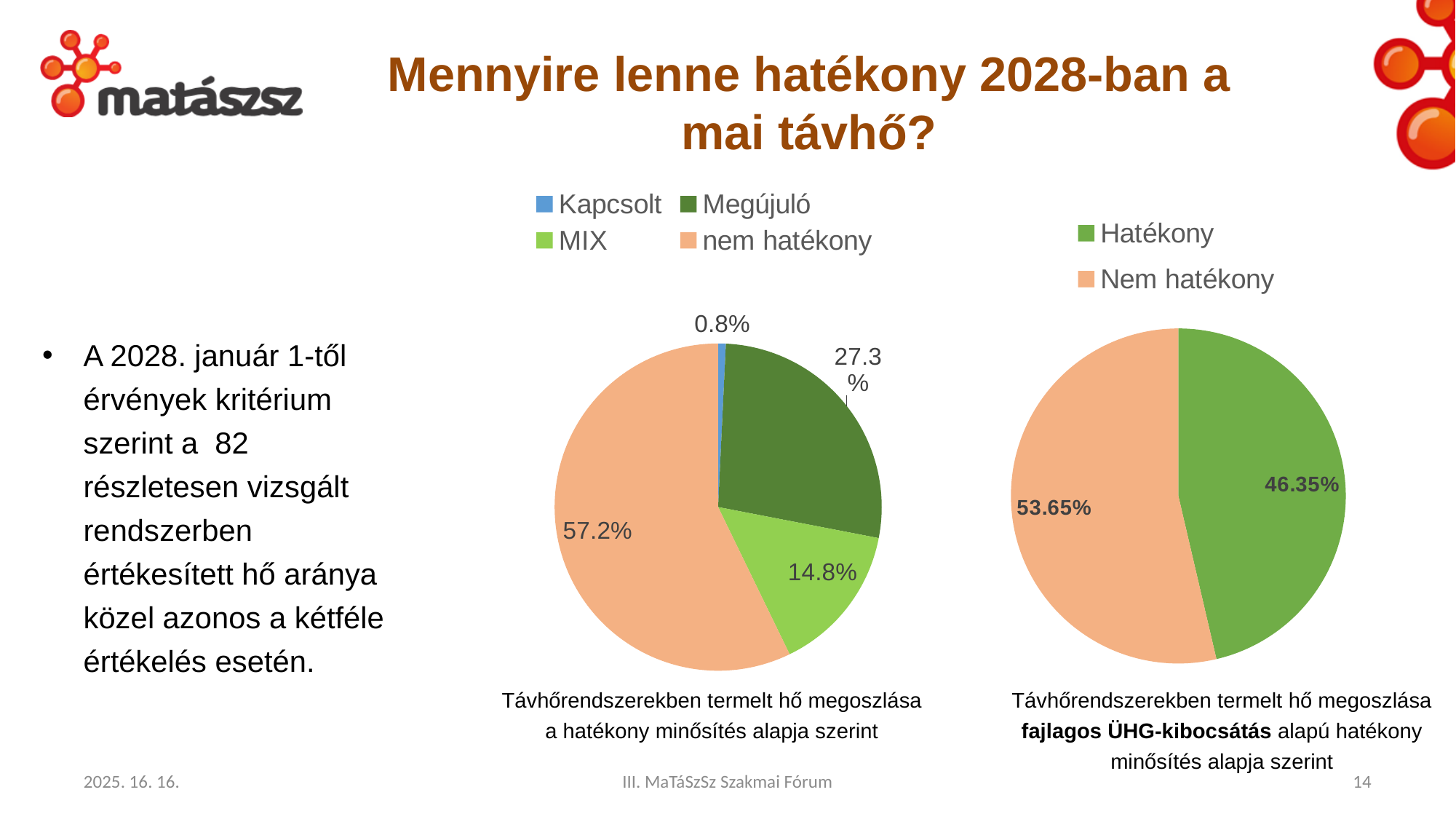
In the left pie chart, which category has the largest slice? nem hatékony In the left pie chart, what is the difference between the 'Megújuló' and 'MIX' shares? 12.5% What type of chart is used on the right side of the slide? Pie chart In the right pie chart, what is the difference between 'Nem hatékony' and 'Hatékony'? 7.30% In the left pie chart, what is the value for 'Megújuló'? 27.3% In the left pie chart, which category has the smallest slice? Kapcsolt In the right pie chart, what is the value for 'Nem hatékony'? 53.65% In the right pie chart, which is larger: 'Hatékony' or 'Nem hatékony'? Nem hatékony How many categories does the legend of the left pie chart list? 4 In the left pie chart, what is the value for 'MIX'? 14.8% In the right pie chart, what is the value for 'Hatékony'? 46.35% In the left pie chart, what share does the 'nem hatékony' slice have? 57.2%